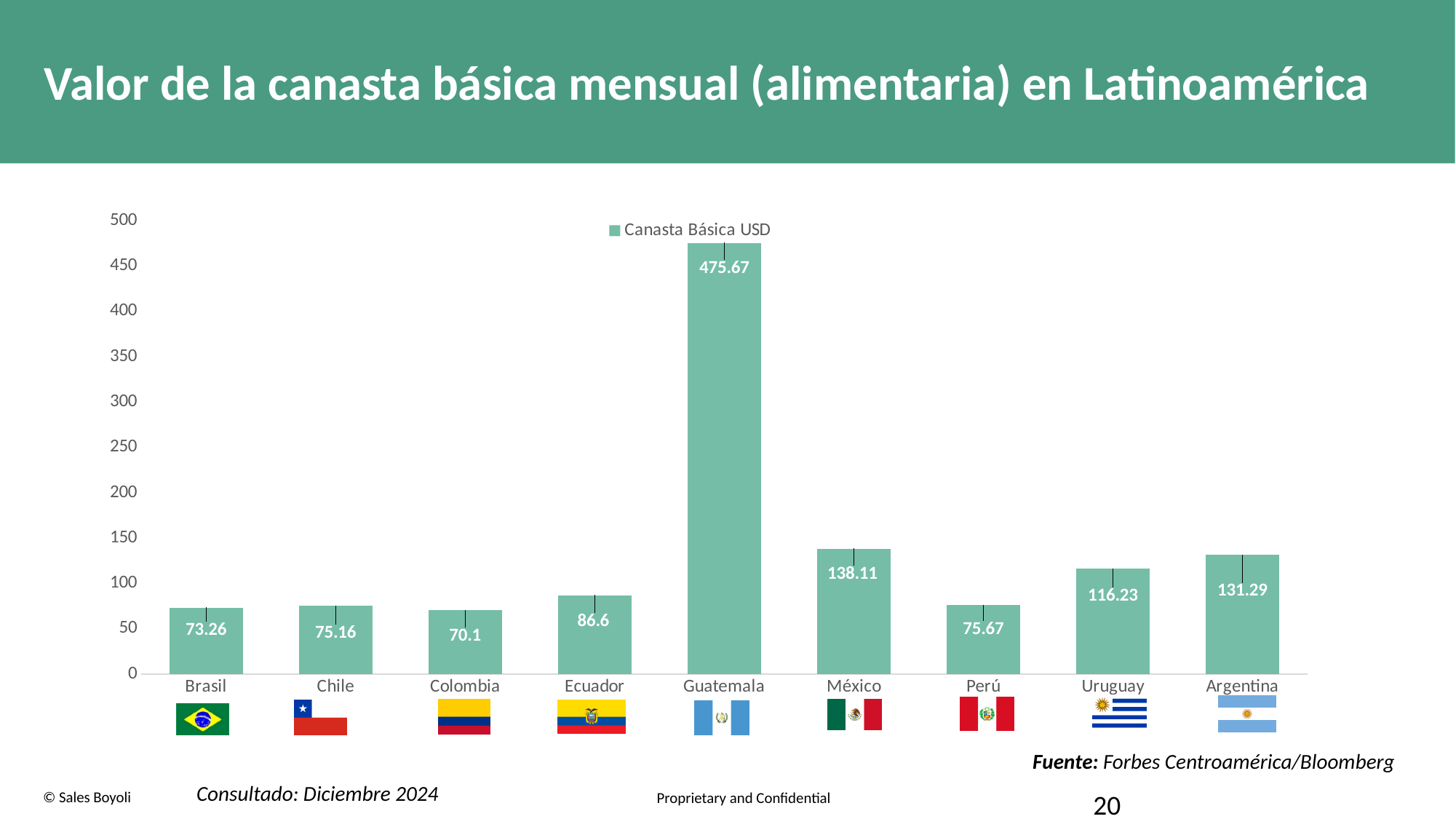
Which is larger, the value for Ecuador or the value for Perú? Ecuador What is the legend entry of the chart? Canasta Básica USD What kind of chart is shown on the slide? bar chart Which country has the highest value? Guatemala What is the value for Colombia? 70.1 What is the value for Guatemala? 475.67 What is the value for México? 138.11 Which country has the lowest value? Colombia Is the value for México greater or less than 100? greater How many countries are shown on the chart? 9 What is the value for Uruguay? 116.23 What is the difference between the values for Argentina and Uruguay? 15.06